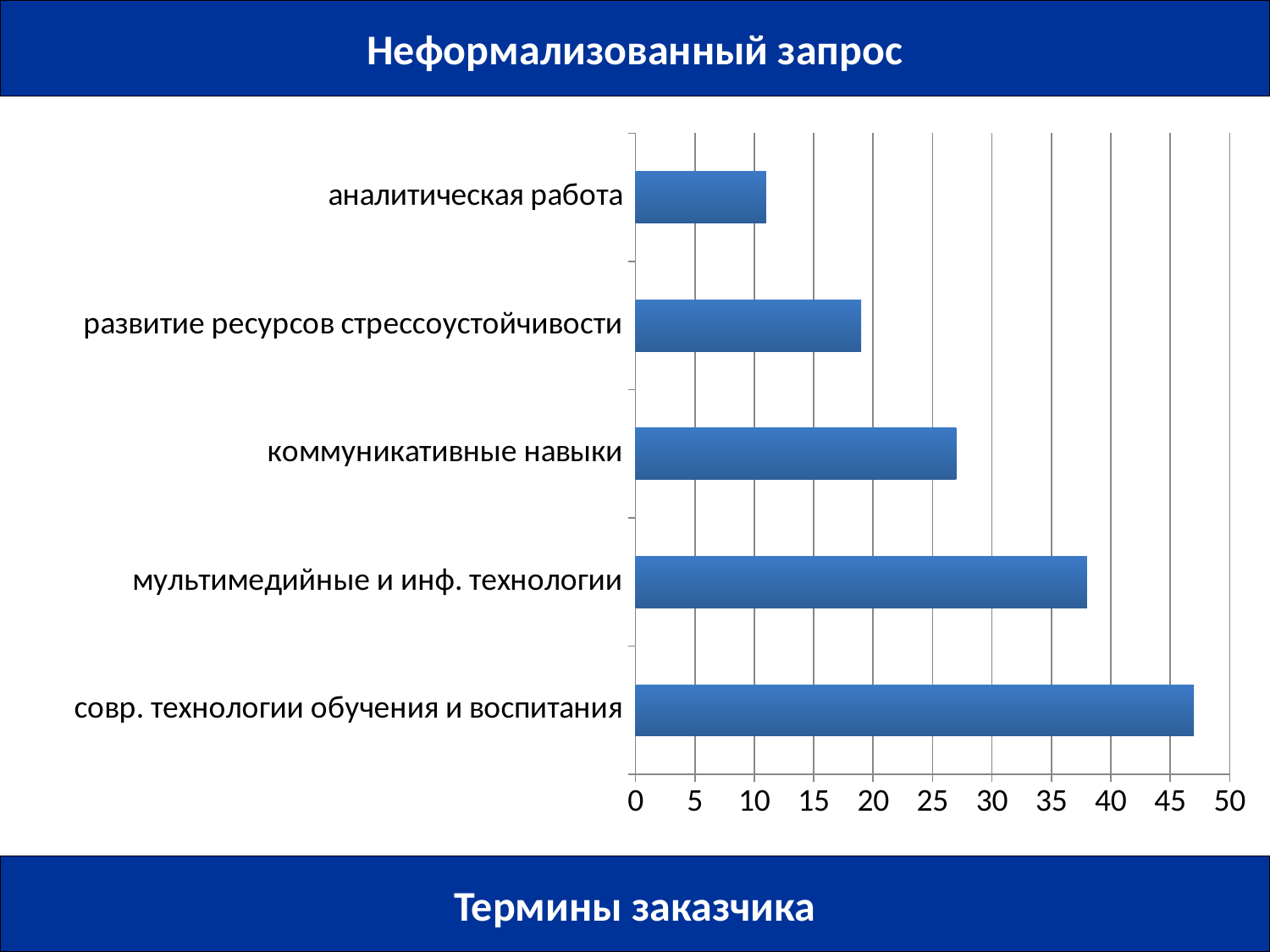
Is the value for аналитическая работа greater or less than 15? less Is the value for мультимедийные и инф. технологии greater or less than 35? greater How many categories are plotted in the chart? 5 Which category has the highest value? совр. технологии обучения и воспитания Is the value for коммуникативные навыки greater or less than 30? less What kind of chart is shown on the slide? bar chart Which is larger: the value for коммуникативные навыки or the value for развитие ресурсов стрессоустойчивости? коммуникативные навыки Which category has the lowest value? аналитическая работа Which is larger: the value for мультимедийные и инф. технологии or the value for совр. технологии обучения и воспитания? совр. технологии обучения и воспитания What is the maximum value shown on the horizontal axis? 50